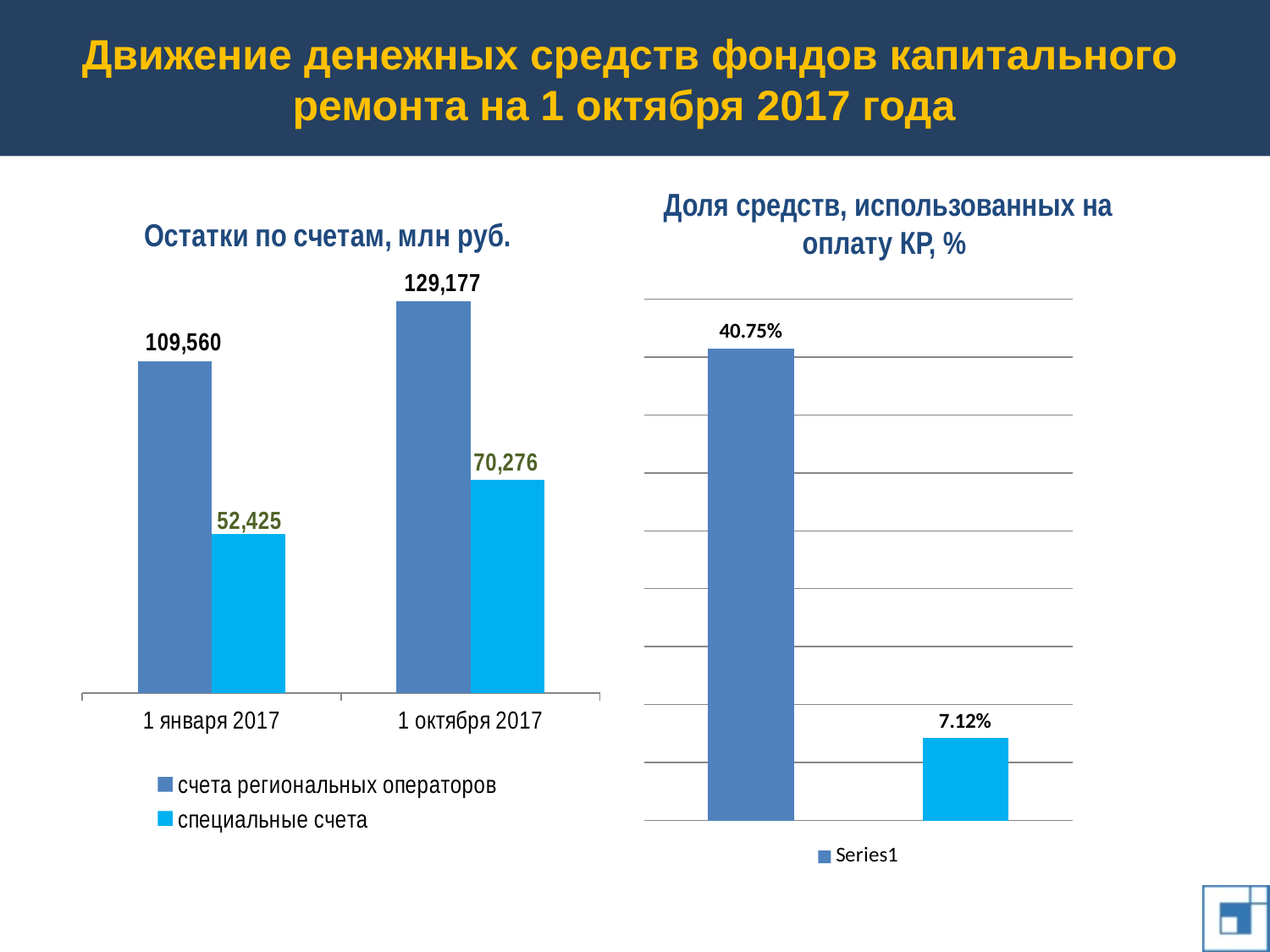
What type of chart is 'Остатки по счетам, млн руб.'? bar chart In the chart 'Доля средств, использованных на оплату КР, %', what is the value of the left (taller) bar? 40.75% In the chart 'Доля средств, использованных на оплату КР, %', what is the value of the right (shorter) bar? 7.12% In the chart 'Остатки по счетам, млн руб.', which series has the higher value on 1 января 2017? счета региональных операторов In the chart 'Остатки по счетам, млн руб.', what is the value for 'специальные счета' on 1 октября 2017? 70,276 In the chart 'Остатки по счетам, млн руб.', by how much did 'счета региональных операторов' change from 1 января 2017 to 1 октября 2017? 19,617 In the chart 'Остатки по счетам, млн руб.', do the values for 'специальные счета' rise or fall from 1 января 2017 to 1 октября 2017? rise How many series does the legend of the chart 'Остатки по счетам, млн руб.' list? 2 In the chart 'Остатки по счетам, млн руб.', what is the value for 'специальные счета' on 1 января 2017? 52,425 In the chart 'Остатки по счетам, млн руб.', what is the value for 'счета региональных операторов' on 1 января 2017? 109,560 In the chart 'Доля средств, использованных на оплату КР, %', what is the difference between the two bars? 33.63% In the chart 'Остатки по счетам, млн руб.', what is the difference between 'счета региональных операторов' and 'специальные счета' on 1 октября 2017? 58,901